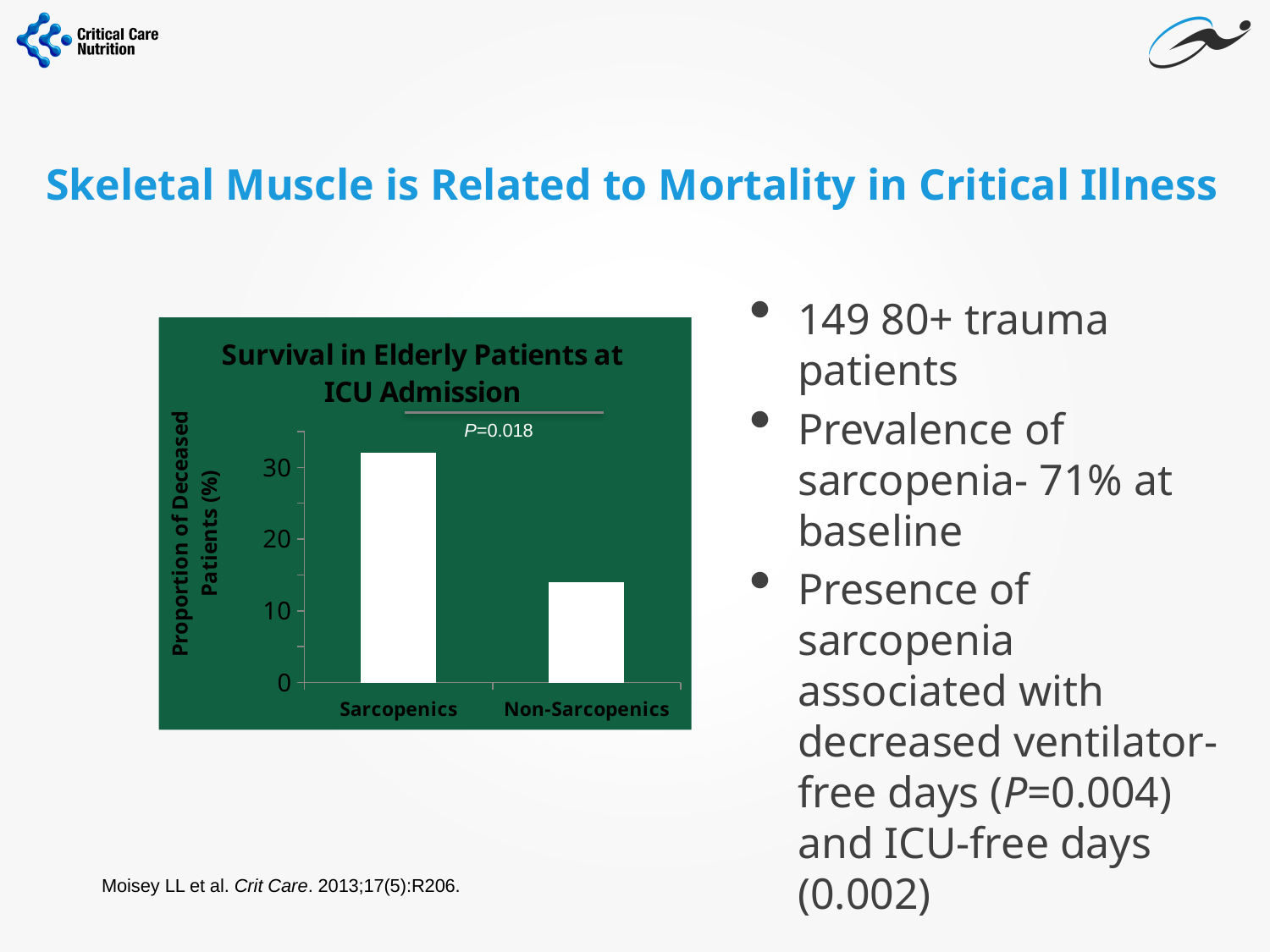
Which category has the highest proportion of deceased patients? Sarcopenics Is the value for Non-Sarcopenics greater or less than 10? greater What is the title of the chart? Survival in Elderly Patients at ICU Admission Which bar is taller, Sarcopenics or Non-Sarcopenics? Sarcopenics What kind of chart is shown on the slide? Bar chart Which category has the lowest proportion of deceased patients? Non-Sarcopenics How many categories are plotted on the x axis of the chart? 2 What P value is annotated on the chart? P=0.018 Is the value for Non-Sarcopenics greater or less than 20? less Is the value for Sarcopenics greater or less than 30? greater